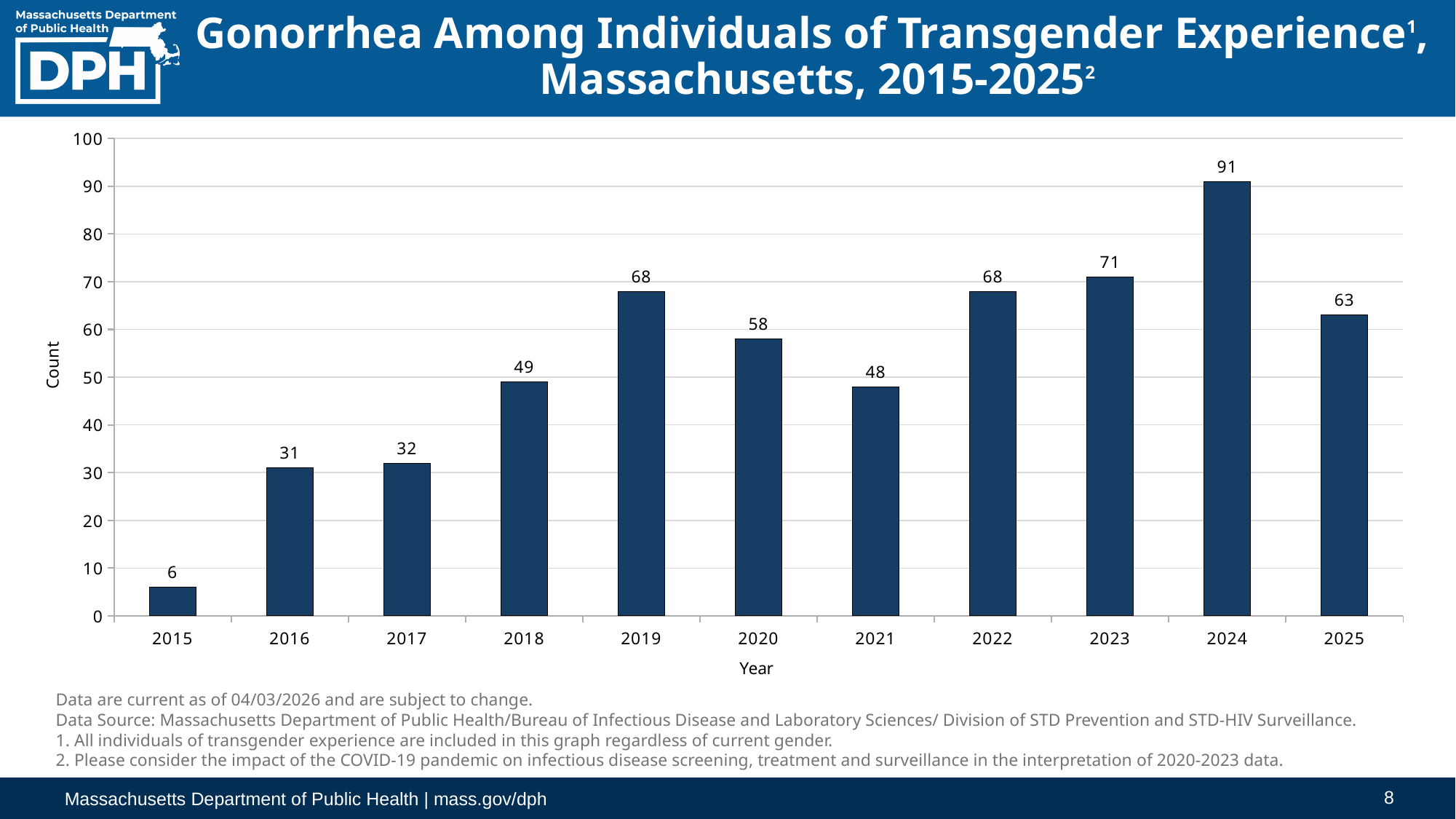
How many years are shown on the x axis? 11 Which year has the highest count? 2024 What kind of chart is shown on the slide? Bar chart Which year has the lowest count? 2015 What is the difference between the counts for 2024 and 2023? 20 What is the count for 2015? 6 Is the value for 2023 greater or less than 60? greater What is the label of the y axis? Count What is the count for 2025? 63 Which year has a larger count, 2018 or 2022? 2022 What is the difference between the counts for 2020 and 2021? 10 What is the count for 2019? 68